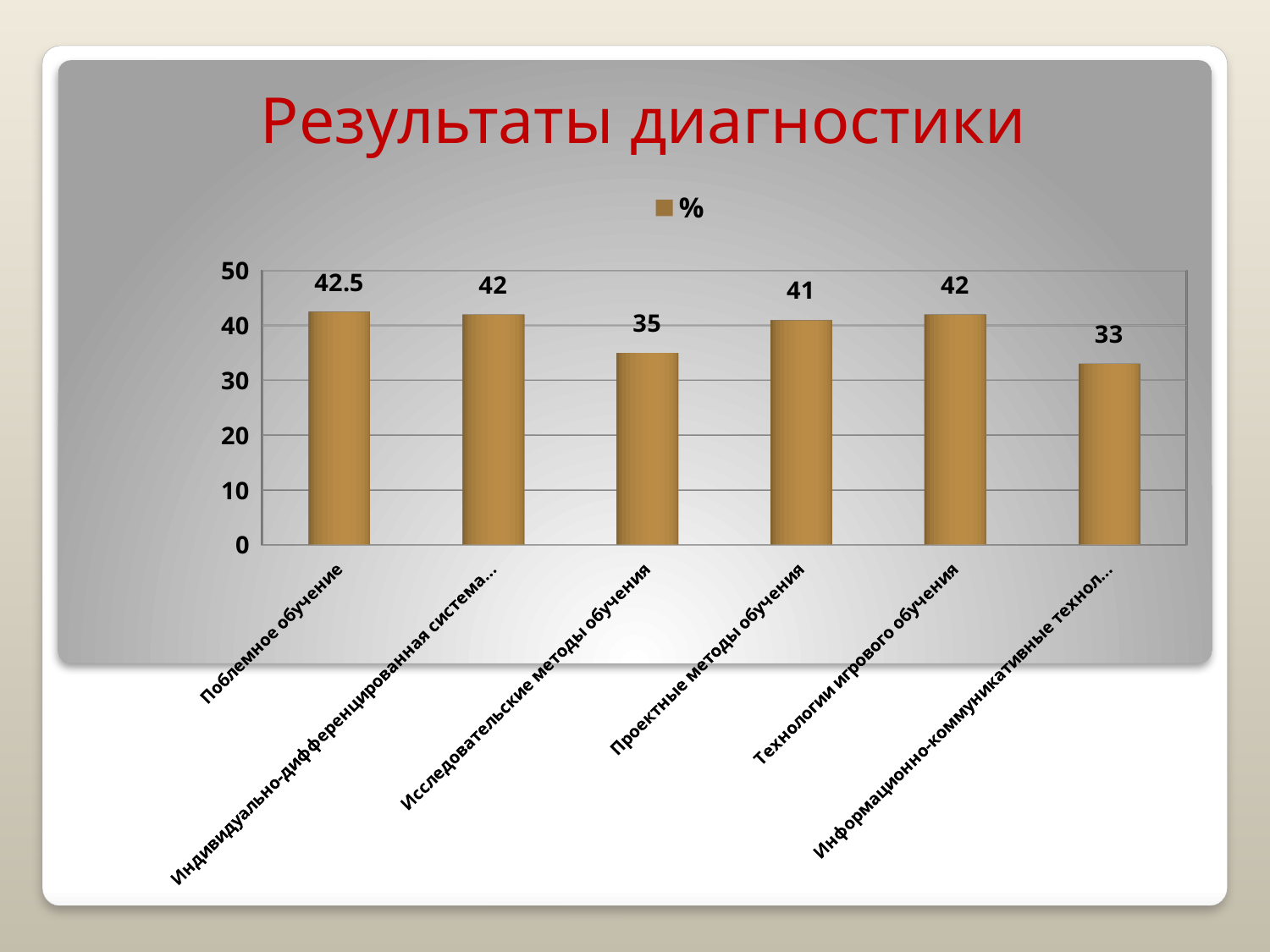
What is the name of the series shown in the legend? % Which category has the lowest value? Информационно-коммуникативные технол... What is the value for Исследовательские методы обучения? 35 What is the difference between the values for Технологии игрового обучения and Информационно-коммуникативные технол...? 9 What is the value for Технологии игрового обучения? 42 Which category has the highest value? Поблемное обучение How many categories are shown in the chart? 6 What kind of chart is shown on the slide? Bar chart What is the value for Проектные методы обучения? 41 Which is larger, the value for Проектные методы обучения or the value for Исследовательские методы обучения? Проектные методы обучения What is the value for Поблемное обучение? 42.5 What is the difference between the values for Поблемное обучение and Исследовательские методы обучения? 7.5